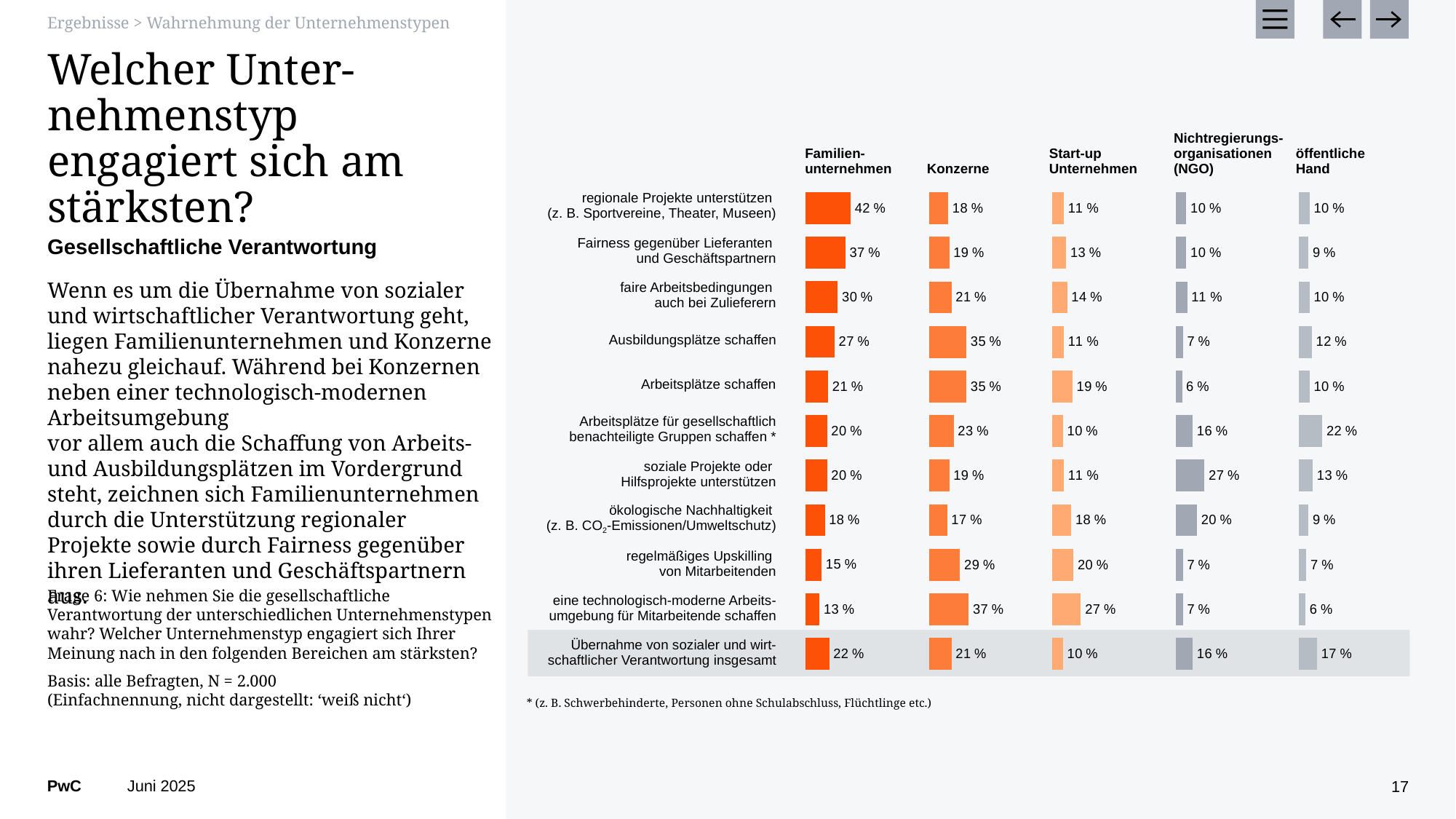
What kind of chart is shown on the slide? bar chart What percentage of respondents see Familienunternehmen as most engaged in 'regionale Projekte unterstützen'? 42 % What value is shown for öffentliche Hand in the row 'Arbeitsplätze für gesellschaftlich benachteiligte Gruppen schaffen'? 22 % Which company type has the highest value in the row 'Übernahme von sozialer und wirtschaftlicher Verantwortung insgesamt'? Familienunternehmen What value is shown for Nichtregierungsorganisationen (NGO) in the row 'soziale Projekte oder Hilfsprojekte unterstützen'? 27 % Which company type has the lowest value in the row 'Arbeitsplätze schaffen'? Nichtregierungsorganisationen (NGO) How many rows (areas of engagement) does the chart show? 11 Which company type's bars are shown in the darkest orange colour? Familienunternehmen In the row 'regelmäßiges Upskilling von Mitarbeitenden', which is larger: Konzerne or Start-up Unternehmen? Konzerne What value is shown for Konzerne in the row 'eine technologisch-moderne Arbeitsumgebung für Mitarbeitende schaffen'? 37 % How many company types are compared in the chart? 5 What is the difference between Familienunternehmen and Konzerne in the row 'regionale Projekte unterstützen'? 24 %